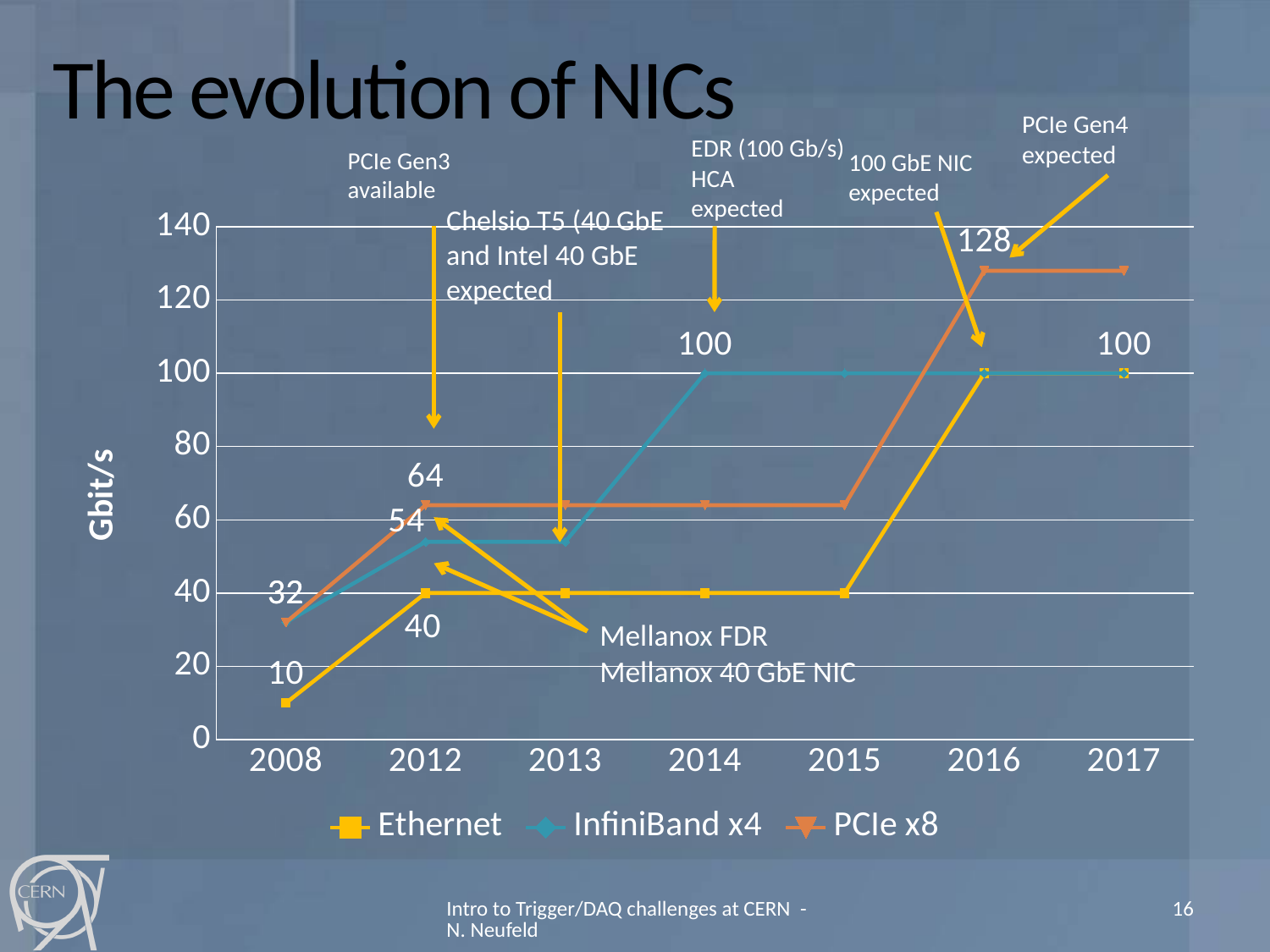
What is the Ethernet value in 2008? 10 Is the Ethernet value in 2015 greater or less than 60? less What is the difference between the PCIe x8 value in 2016 and its value in 2008? 96 How many series does the legend list? 3 What is the label on the y axis? Gbit/s Which series has the highest value in 2016? PCIe x8 What is the InfiniBand x4 value in 2012? 54 How many years are shown on the x axis? 7 What is the PCIe x8 value in 2012? 64 What is the PCIe x8 value in 2016? 128 In 2012, which is larger: the PCIe x8 value or the InfiniBand x4 value? PCIe x8 What kind of chart is shown on the slide? line chart